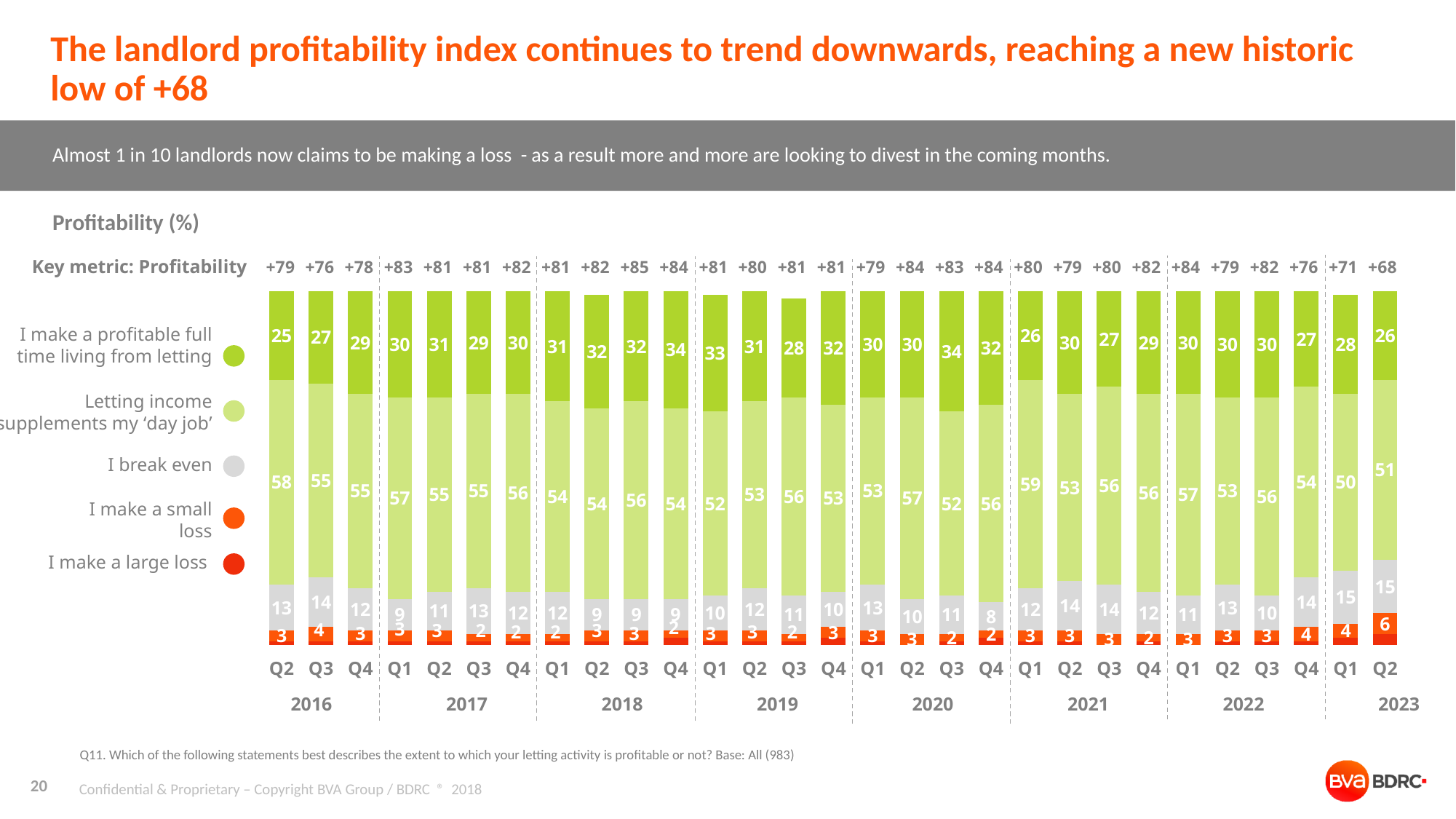
Which is larger: the 'I make a profitable full time living from letting' value in Q4 2018 or in Q2 2016? Q4 2018 What is the 'I make a small loss' value for Q2 2023? 6 What is the 'I break even' value for Q2 2023? 15 What kind of chart is shown on the slide? Stacked bar chart In which quarter is the 'Letting income supplements my day job' segment highest? Q1 2021 (59) What is the Key metric: Profitability value for Q2 2023? +68 Which quarter has the highest Key metric: Profitability value? Q3 2018 (+85) What percentage of landlords said 'I make a profitable full time living from letting' in Q2 2016? 25 By how much did the Key metric: Profitability fall from Q1 2023 to Q2 2023? 3 How many series does the legend list? 5 Does the Key metric: Profitability rise or fall from Q4 2022 to Q2 2023? Fall Which quarter has the lowest Key metric: Profitability value? Q2 2023 (+68)